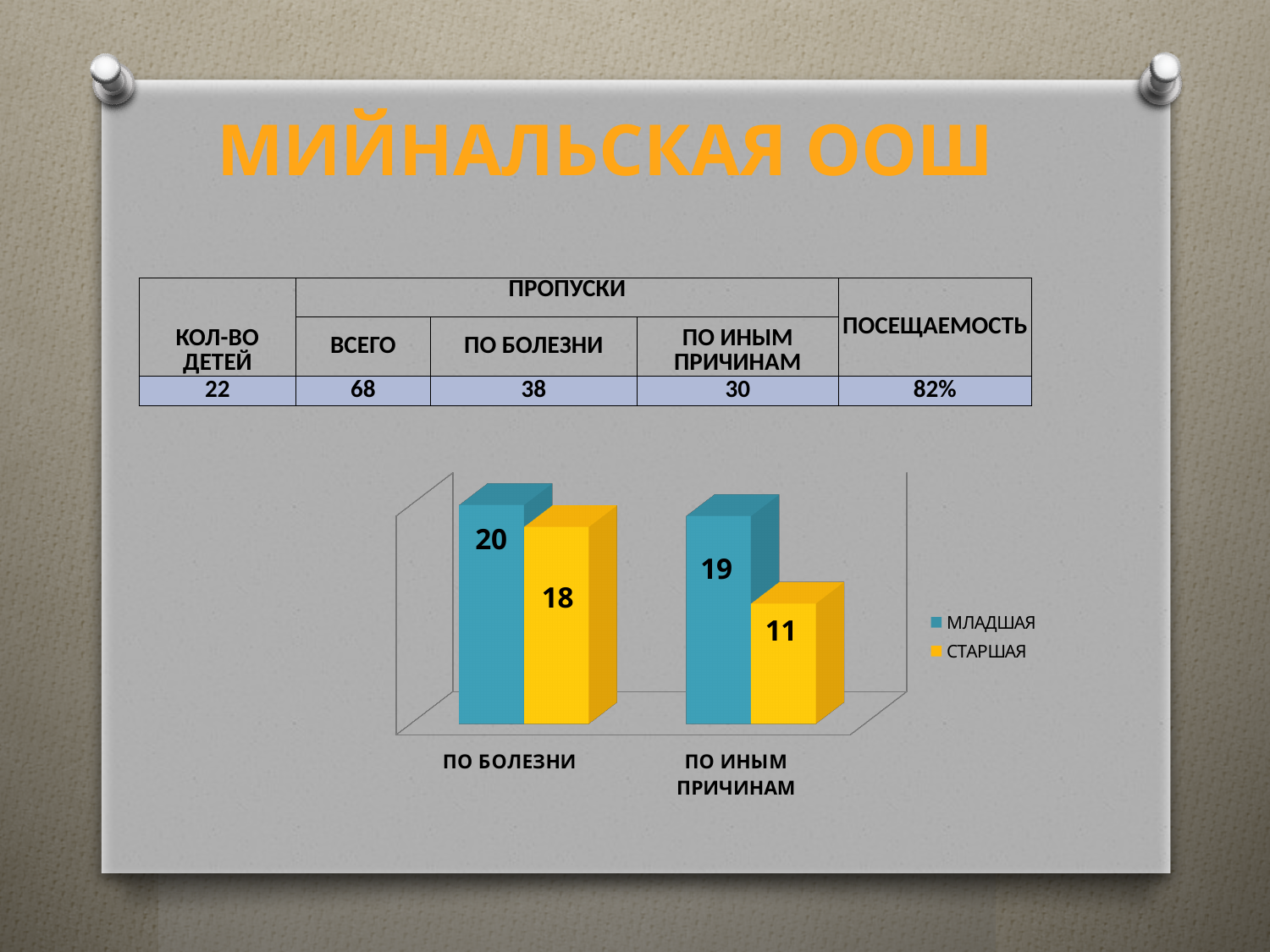
How many series does the chart legend list? 2 How many categories are shown on the x axis of the chart? 2 What is the value for СТАРШАЯ in the ПО ИНЫМ ПРИЧИНАМ category? 11 Which colour represents the СТАРШАЯ series in the chart? yellow What is the difference between the МЛАДШАЯ and СТАРШАЯ values in the ПО ИНЫМ ПРИЧИНАМ category? 8 What kind of chart is shown on the slide? bar chart What is the value for СТАРШАЯ in the ПО БОЛЕЗНИ category? 18 Which is larger: the СТАРШАЯ value for ПО БОЛЕЗНИ or the СТАРШАЯ value for ПО ИНЫМ ПРИЧИНАМ? ПО БОЛЕЗНИ What is the difference between the МЛАДШАЯ and СТАРШАЯ values in the ПО БОЛЕЗНИ category? 2 What is the value for МЛАДШАЯ in the ПО БОЛЕЗНИ category? 20 What is the value for МЛАДШАЯ in the ПО ИНЫМ ПРИЧИНАМ category? 19 Which series has the lowest value in the ПО ИНЫМ ПРИЧИНАМ category? СТАРШАЯ